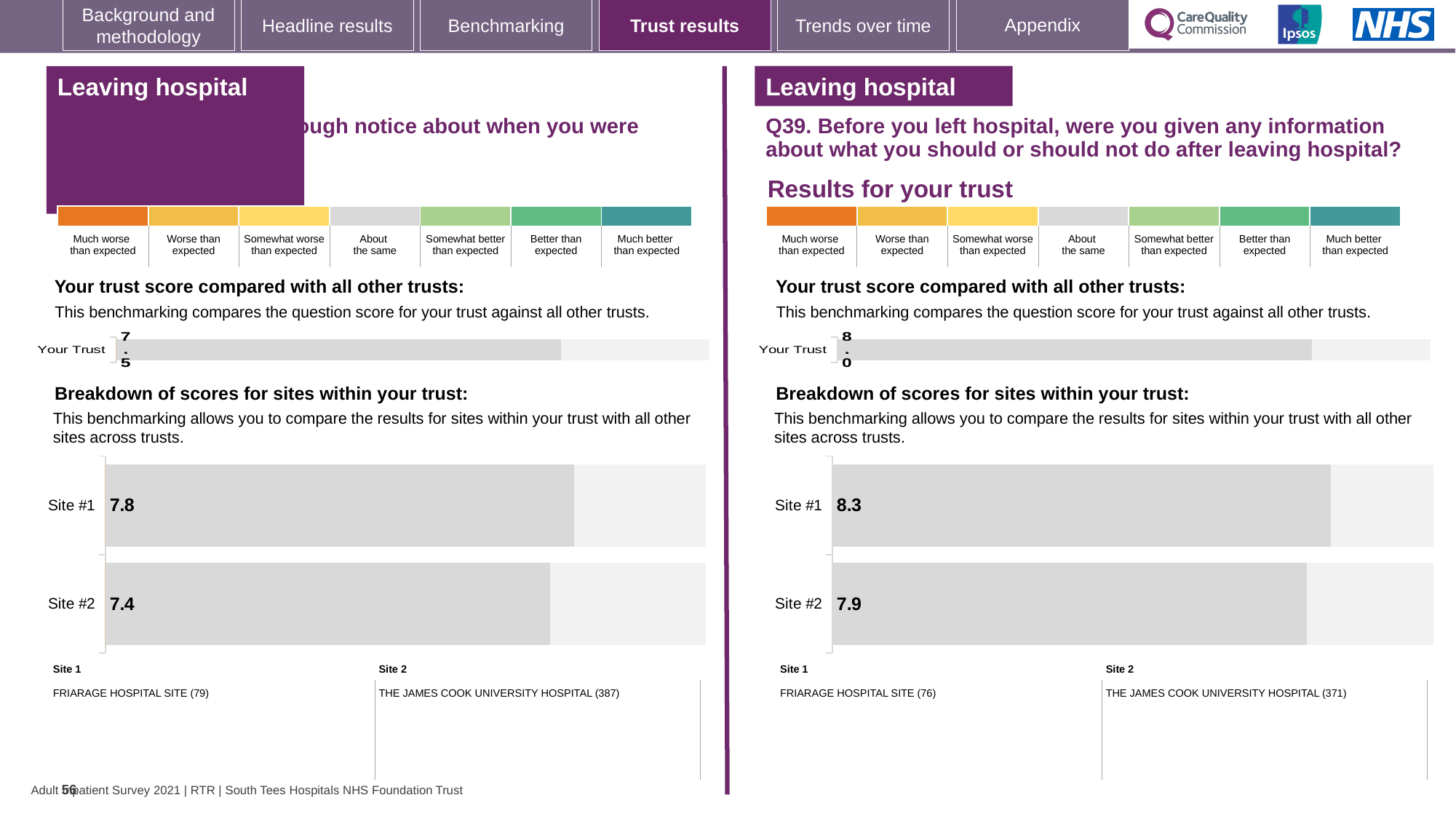
What type of chart is used for the site breakdown on the left half of the slide? Bar chart In the right-hand (Q39) 'Breakdown of scores for sites within your trust' chart, what is the score for Site #2? 7.9 In the left-hand 'Breakdown of scores for sites within your trust' chart, what is the score for Site #1? 7.8 On the left half of the slide, what is the trust score shown in the 'Your trust score compared with all other trusts' chart? 7.5 In the right-hand (Q39) site breakdown chart, what is the difference between the Site #1 and Site #2 scores? 0.4 In the right-hand (Q39) 'Breakdown of scores for sites within your trust' chart, what is the score for Site #1? 8.3 How many sites are shown in the right-hand (Q39) site breakdown chart? 2 In the left-hand site breakdown chart, what is the difference between the Site #1 and Site #2 scores? 0.4 On the right half of the slide (Q39), what is the trust score shown in the 'Your trust score compared with all other trusts' chart? 8.0 In the left-hand site breakdown chart, which site has the higher score? Site #1 In the right-hand (Q39) site breakdown chart, which site has the lower score? Site #2 In the left-hand 'Breakdown of scores for sites within your trust' chart, what is the score for Site #2? 7.4